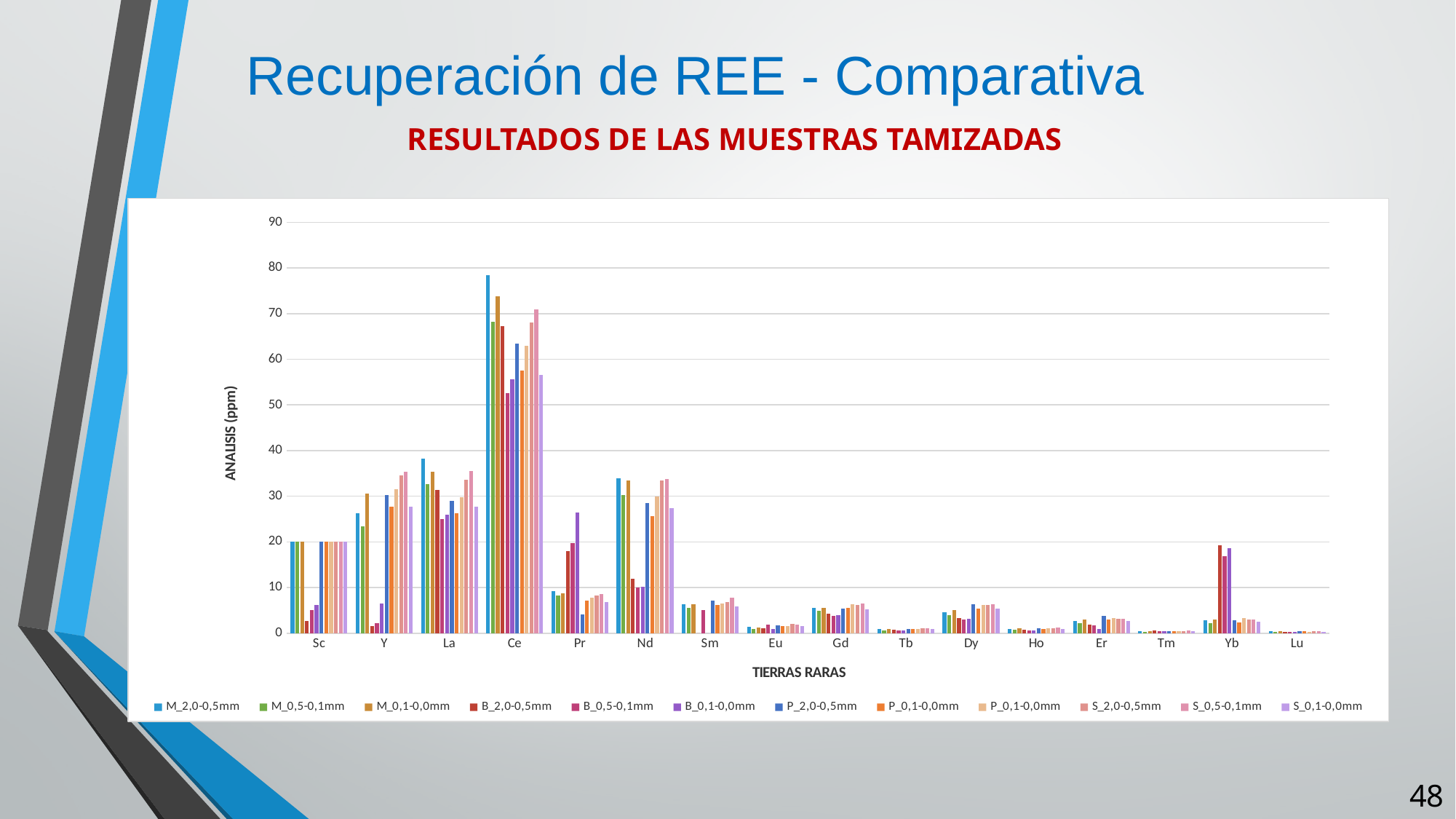
Which element category has the highest bars in the chart? Ce How many series does the chart legend list? 12 Is the value for B_2,0-0,5mm at Ce greater or less than 40? greater What is the label of the vertical axis of the chart? ANALISIS (ppm) How many rare earth element categories are shown on the x axis of the chart? 16 Is the value for B_2,0-0,5mm at Yb greater or less than 10? greater Is the value for M_2,0-0,5mm at La greater or less than 30? greater What kind of chart is shown on the slide? bar chart For the M_2,0-0,5mm series, which is larger: the value at La or the value at Y? La At Ce, which is larger: the value for M_2,0-0,5mm or the value for B_2,0-0,5mm? M_2,0-0,5mm